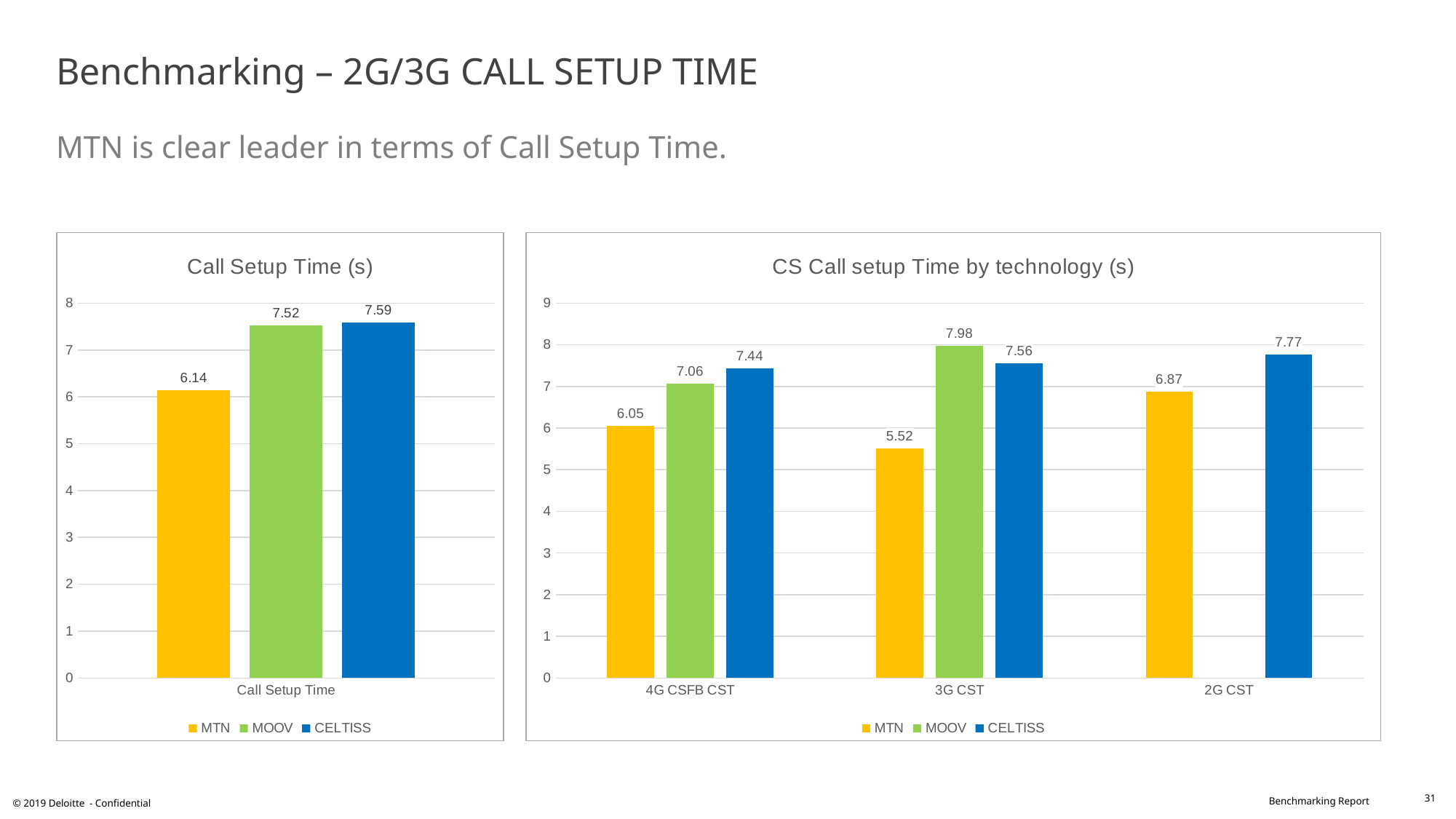
In the 'CS Call setup Time by technology (s)' chart, which is larger: MTN's 4G CSFB CST value or MTN's 2G CST value? MTN's 2G CST value In the 'Call Setup Time (s)' chart, how many series does the legend list? 3 In the 'CS Call setup Time by technology (s)' chart, which colour represents CELTISS? Blue In the 'CS Call setup Time by technology (s)' chart, how many technology categories are shown on the x axis? 3 In the 'CS Call setup Time by technology (s)' chart, what is the difference between the MOOV and MTN values for 3G CST? 2.46 In the 'CS Call setup Time by technology (s)' chart, what is the value for MOOV in the 3G CST category? 7.98 In the 'CS Call setup Time by technology (s)' chart, what is the value for CELTISS in the 2G CST category? 7.77 In the 'Call Setup Time (s)' chart, what is the difference between the CELTISS and MTN values? 1.45 In the 'CS Call setup Time by technology (s)' chart, which operator has the lowest value in the 4G CSFB CST category? MTN In the 'Call Setup Time (s)' chart, which operator has the highest call setup time? CELTISS In the 'Call Setup Time (s)' chart, what is the value for MTN? 6.14 What kind of chart is the 'CS Call setup Time by technology (s)' chart? Bar chart